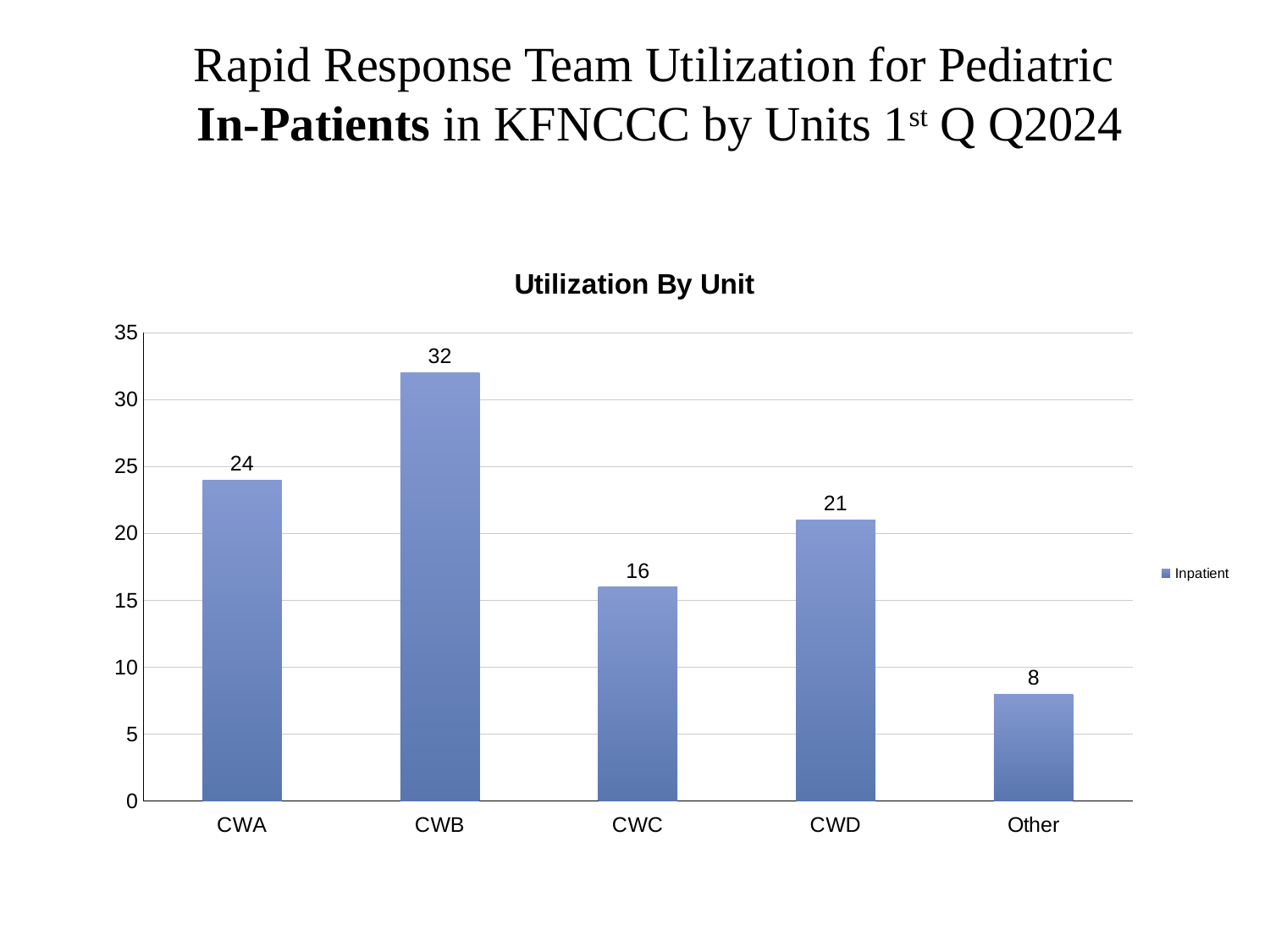
Which category has the lowest utilization? Other What is the value for the Other category? 8 What kind of chart is shown on the slide? Bar chart What is the difference between the values for CWD and CWC? 5 Is the value for CWC greater or less than 20? less How many categories are shown on the x axis? 5 How many series does the legend list? 1 What is the Inpatient value for CWB? 32 What is the difference between the values for CWB and CWA? 8 Which unit has the highest utilization? CWB Which has a larger value, CWA or CWD? CWA What is the Inpatient value for CWD? 21